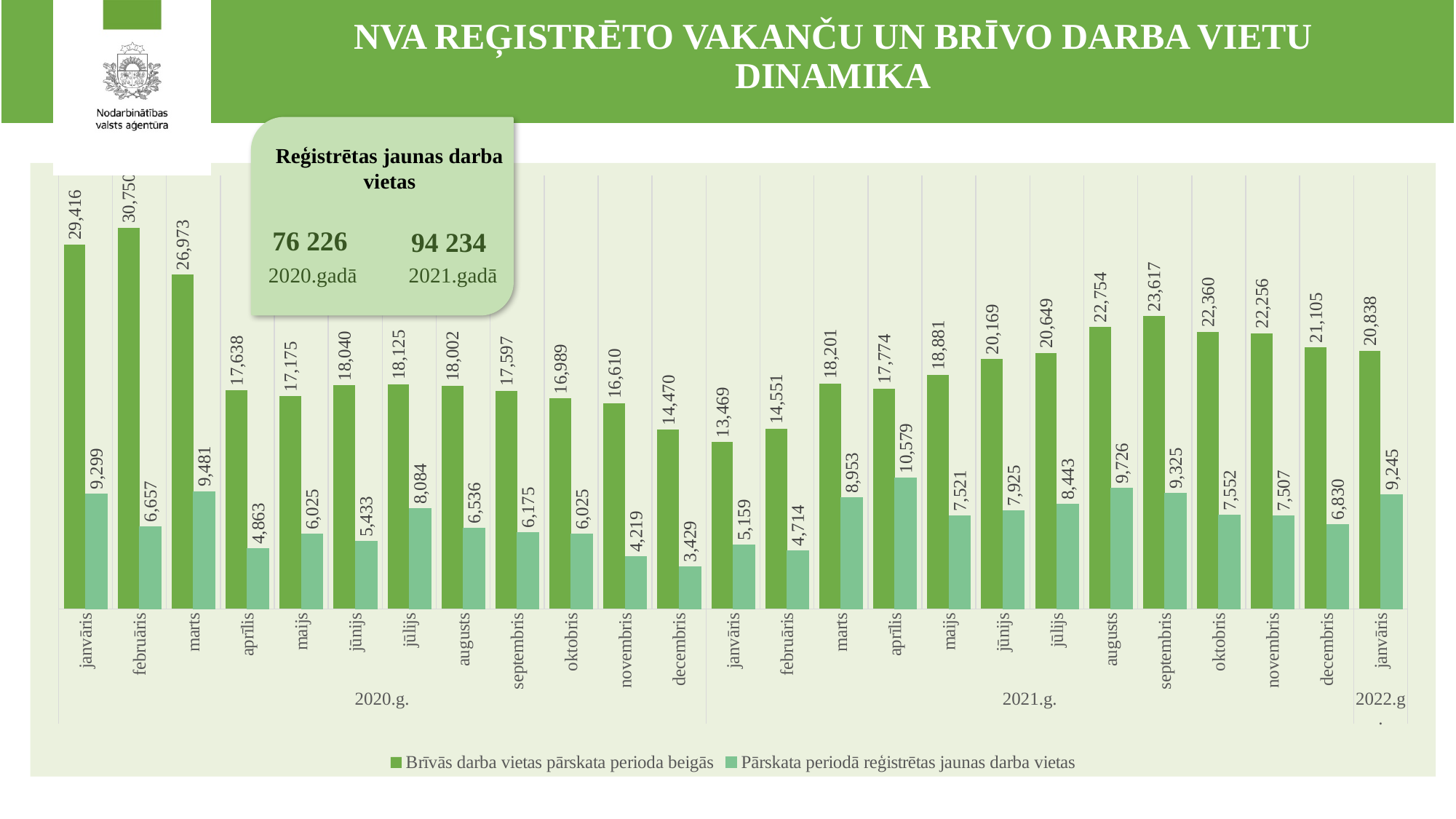
Which is larger for 'Pārskata periodā reģistrētas jaunas darba vietas': augusts 2021 or septembris 2021? augusts 2021 Which month has the highest value for 'Pārskata periodā reģistrētas jaunas darba vietas'? aprīlis 2021 What kind of chart is shown on the slide? bar chart What is the value of 'Brīvās darba vietas pārskata perioda beigās' for septembris 2021? 23,617 What is the value of 'Pārskata periodā reģistrētas jaunas darba vietas' for aprīlis 2021? 10,579 What is the difference between the 'Pārskata periodā reģistrētas jaunas darba vietas' values for aprīlis 2021 and marts 2021? 1,626 How many months are shown on the x axis of the chart? 25 What is the value of 'Brīvās darba vietas pārskata perioda beigās' for marts 2020? 26,973 How many series does the legend list? 2 Which month has the lowest value for 'Pārskata periodā reģistrētas jaunas darba vietas'? decembris 2020 What is the difference between the 'Brīvās darba vietas pārskata perioda beigās' values for decembris 2020 and janvāris 2021? 1,001 Which month has the lowest value for 'Brīvās darba vietas pārskata perioda beigās'? janvāris 2021